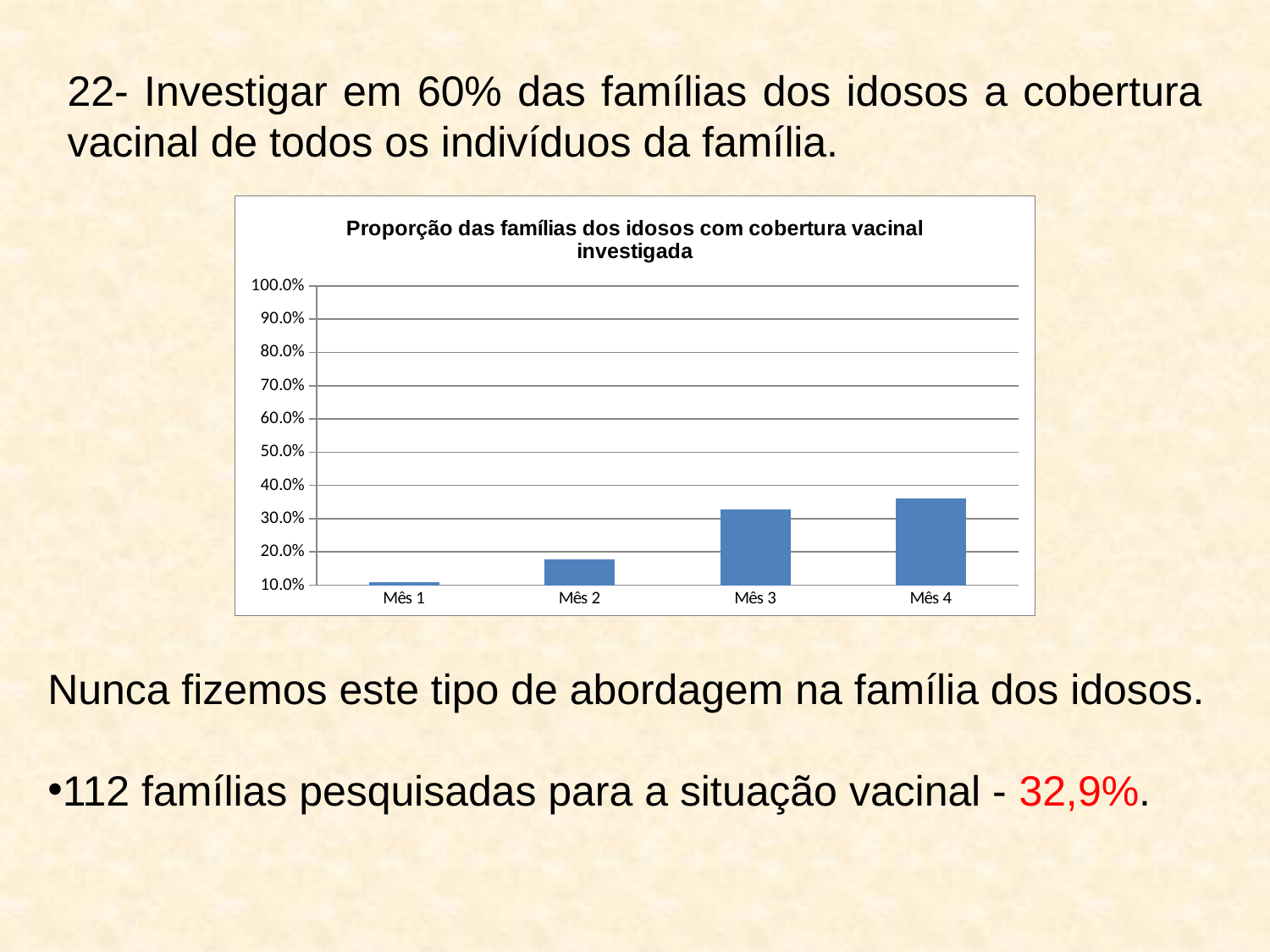
What is the highest value shown on the y axis of the chart? 100.0% Is the value for Mês 2 greater or less than 20.0%? less Which month has the lowest proportion in the chart? Mês 1 What kind of chart is shown on the slide? bar chart Do the values rise or fall from Mês 1 to Mês 4? rise Is the value for Mês 4 greater or less than 40.0%? less Which month has the highest proportion in the chart? Mês 4 Is the value for Mês 3 greater or less than 30.0%? greater Which is larger, the value for Mês 2 or the value for Mês 3? Mês 3 How many categories (months) are shown on the x axis of the chart? 4 What is the title of the chart? Proporção das famílias dos idosos com cobertura vacinal investigada